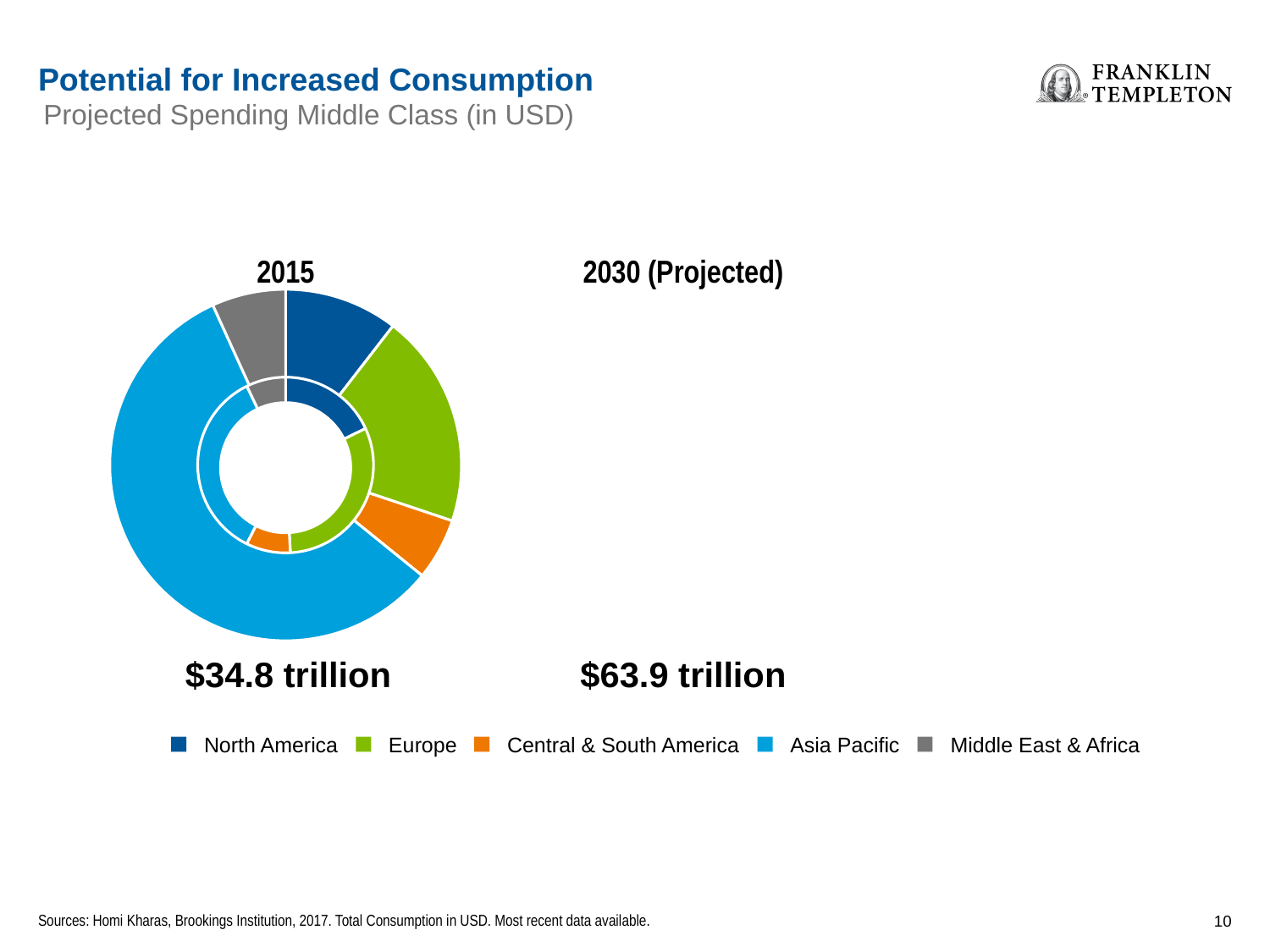
How many regions does the legend list? 5 Which total is larger, 2015 or 2030 (Projected)? 2030 (Projected) Which region has the largest share in the outer ring of the doughnut chart? Asia Pacific What is the total projected middle class spending shown for 2030 (Projected)? $63.9 trillion What kind of chart is shown on the slide? Doughnut chart Which region has the smallest share in the inner ring of the doughnut chart? Middle East & Africa What is the total projected middle class spending shown for 2015? $34.8 trillion What is the title of the slide? Potential for Increased Consumption In the outer ring of the doughnut chart, which share is larger, Asia Pacific or Europe? Asia Pacific In the outer ring of the doughnut chart, which share is larger, Europe or North America? Europe Which colour represents Asia Pacific in the legend? Light blue What is the difference between the 2030 (Projected) total and the 2015 total? $29.1 trillion